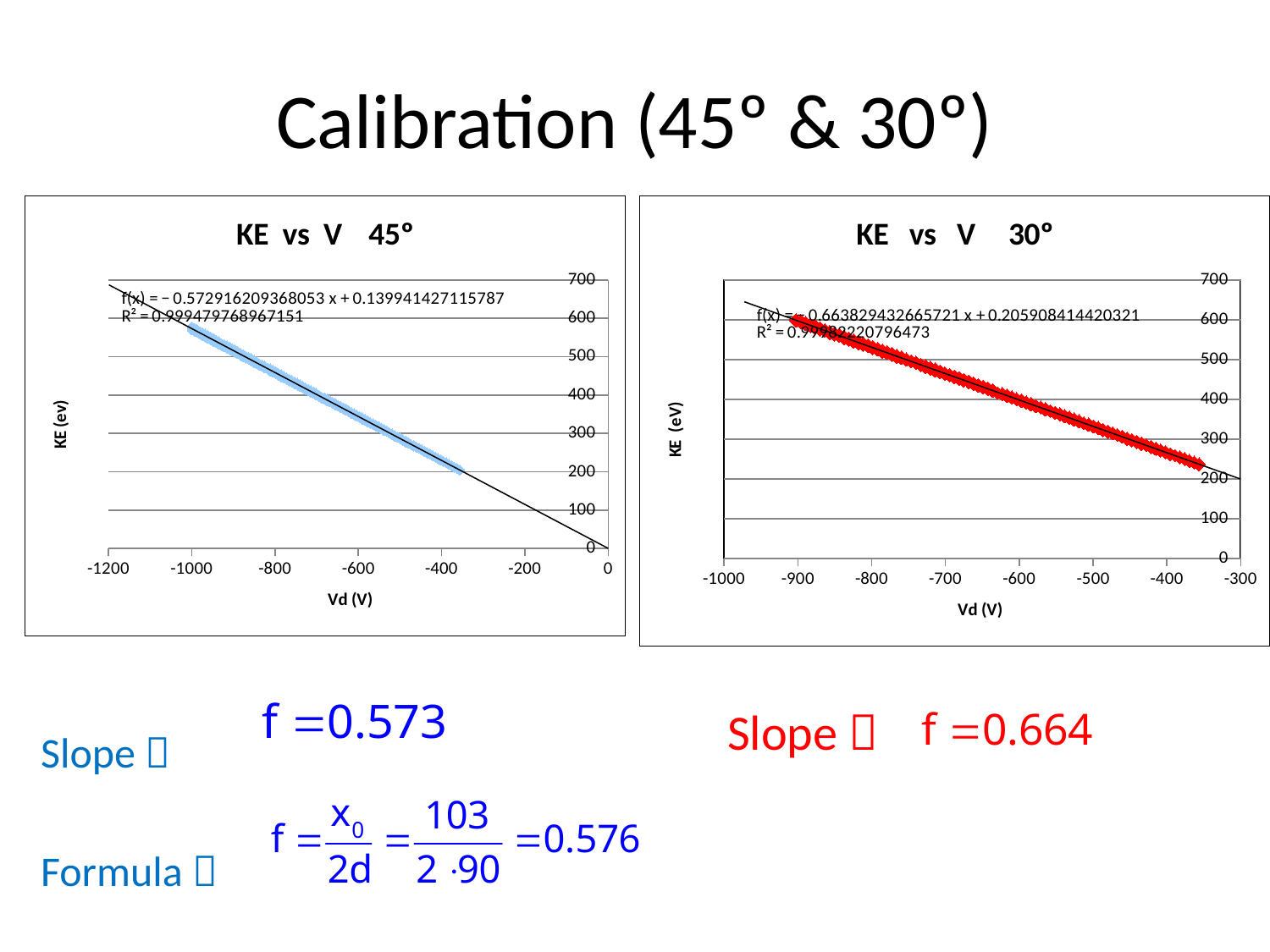
What kind of chart is the left chart titled "KE vs V 45°"? scatter chart In the left chart (KE vs V 45°), do the KE values rise or fall as Vd increases from -1200 toward 0? fall What is the R² value shown on the left chart (KE vs V 45°)? 0.999479768967151 What is the slope in the fitted equation shown on the left chart (KE vs V 45°)? −0.572916209368053 What is the x-axis title of the left chart (KE vs V 45°)? Vd (V) In the right chart (KE vs V 30°), do the KE values rise or fall as Vd increases from -1000 toward -300? fall What is the title of the right chart? KE vs V 30° In the right chart (KE vs V 30°), is the KE value at Vd = -400 greater or less than 300? less In the left chart (KE vs V 45°), is the KE value at Vd = -400 greater or less than 300? less What is the slope in the fitted equation shown on the right chart (KE vs V 30°)? −0.663829432665721 In the left chart (KE vs V 45°), is the KE value at Vd = -600 greater or less than 300? greater